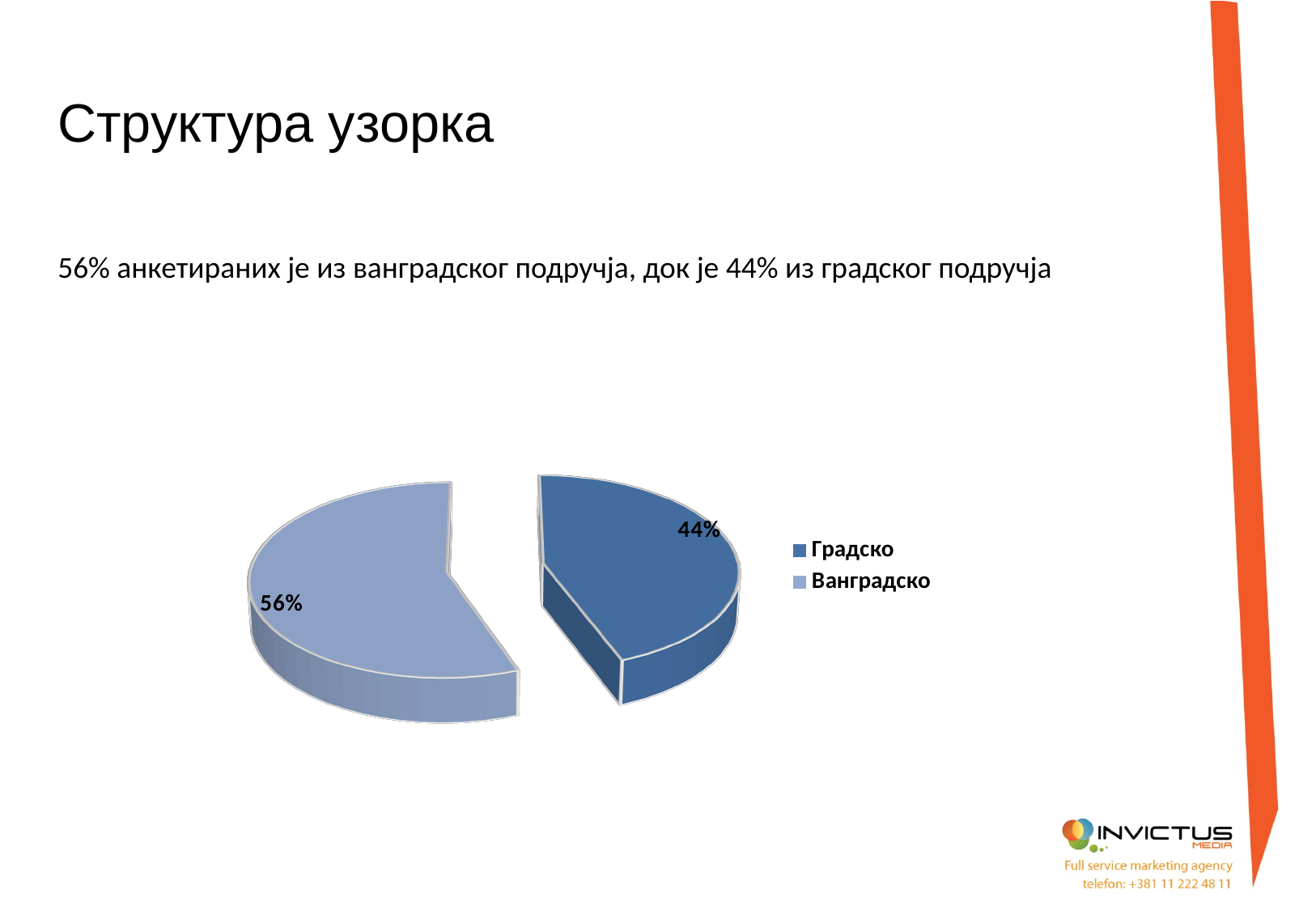
What share of the pie does Ванградско represent? 56% Which legend entry is shown in the darker blue colour? Градско What is the difference in percentage points between the Ванградско and Градско slices? 12 What is the title of the slide containing the chart? Структура узорка How many categories are shown in the pie chart? 2 What share of the pie does Градско represent? 44% Which category has the largest slice of the pie? Ванградско Which category has the smallest slice of the pie? Градско Which is larger, the Градско slice or the Ванградско slice? Ванградско How many entries does the legend list? 2 What kind of chart is shown on the slide? Pie chart